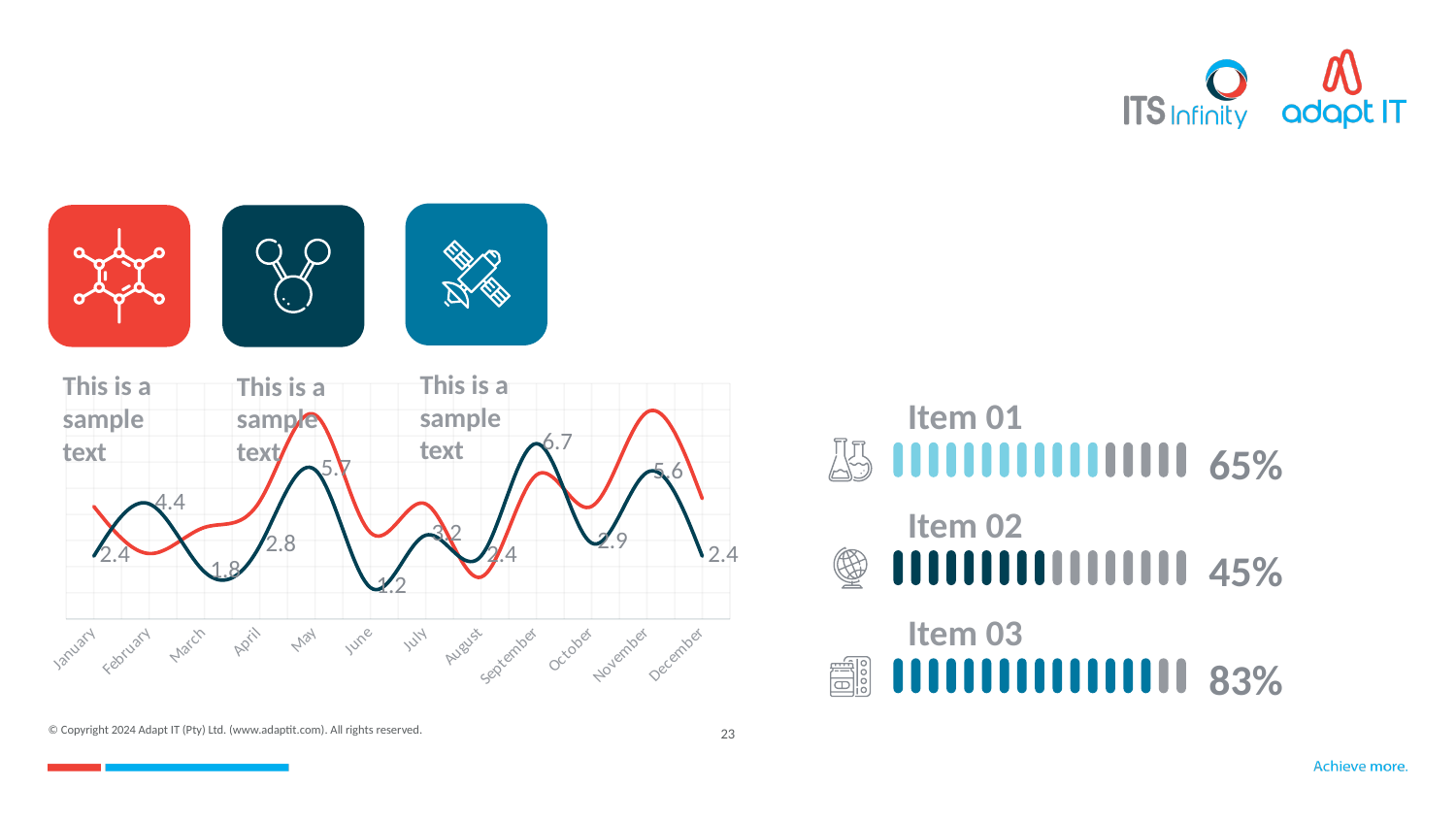
On the line chart, which month has the highest labelled value on the dark line? September On the line chart, what is the labelled value for December on the dark line? 2.4 On the line chart, does the dark line rise or fall from September to October? fall On the line chart, what is the labelled value for March on the dark line? 1.8 On the line chart, what is the labelled value for September on the dark line? 6.7 On the line chart, which month has the lowest labelled value on the dark line? June On the line chart, what is the difference between the labelled values for September and June on the dark line? 5.5 What kind of chart is shown on the left of the slide? line chart How many lines are plotted on the line chart? 2 How many months are shown on the x axis of the line chart? 12 On the line chart, what is the labelled value for February on the dark line? 4.4 On the line chart, which has the larger labelled value on the dark line, May or November? May